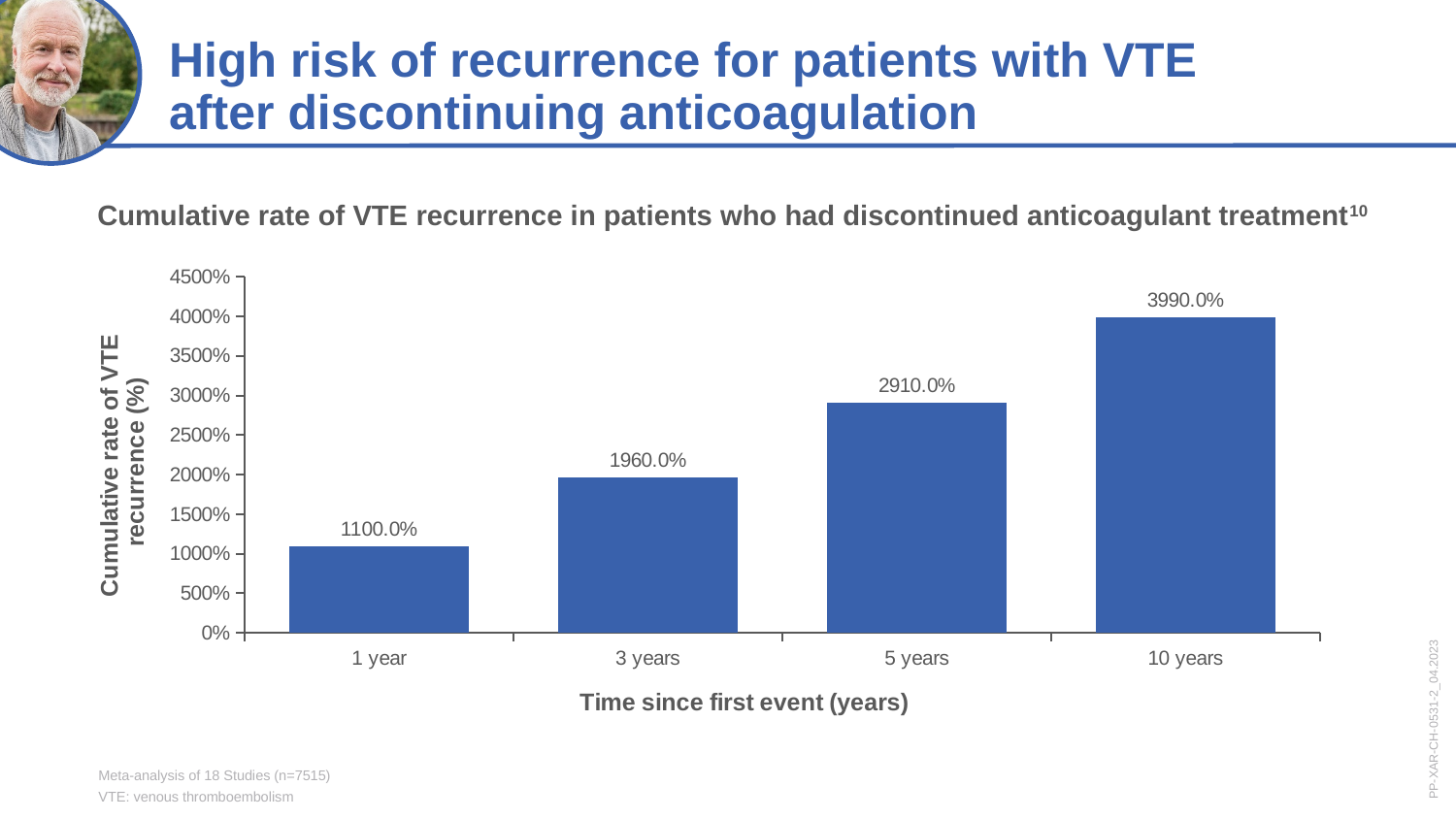
What is the cumulative rate of VTE recurrence at 10 years? 3990.0% How many time points are shown on the x axis of the chart? 4 What is the cumulative rate of VTE recurrence at 3 years? 1960.0% Which time point has the highest cumulative rate of VTE recurrence? 10 years What is the label of the x axis of the chart? Time since first event (years) What kind of chart is shown on the slide? Bar chart Which is larger, the cumulative recurrence rate at 3 years or at 5 years? 5 years What is the cumulative rate of VTE recurrence at 1 year? 1100.0% What is the difference between the cumulative recurrence rate at 10 years and at 1 year? 2890.0% Do the cumulative recurrence rates rise or fall as time since first event increases? Rise What is the cumulative rate of VTE recurrence at 5 years? 2910.0% Which time point has the lowest cumulative rate of VTE recurrence? 1 year